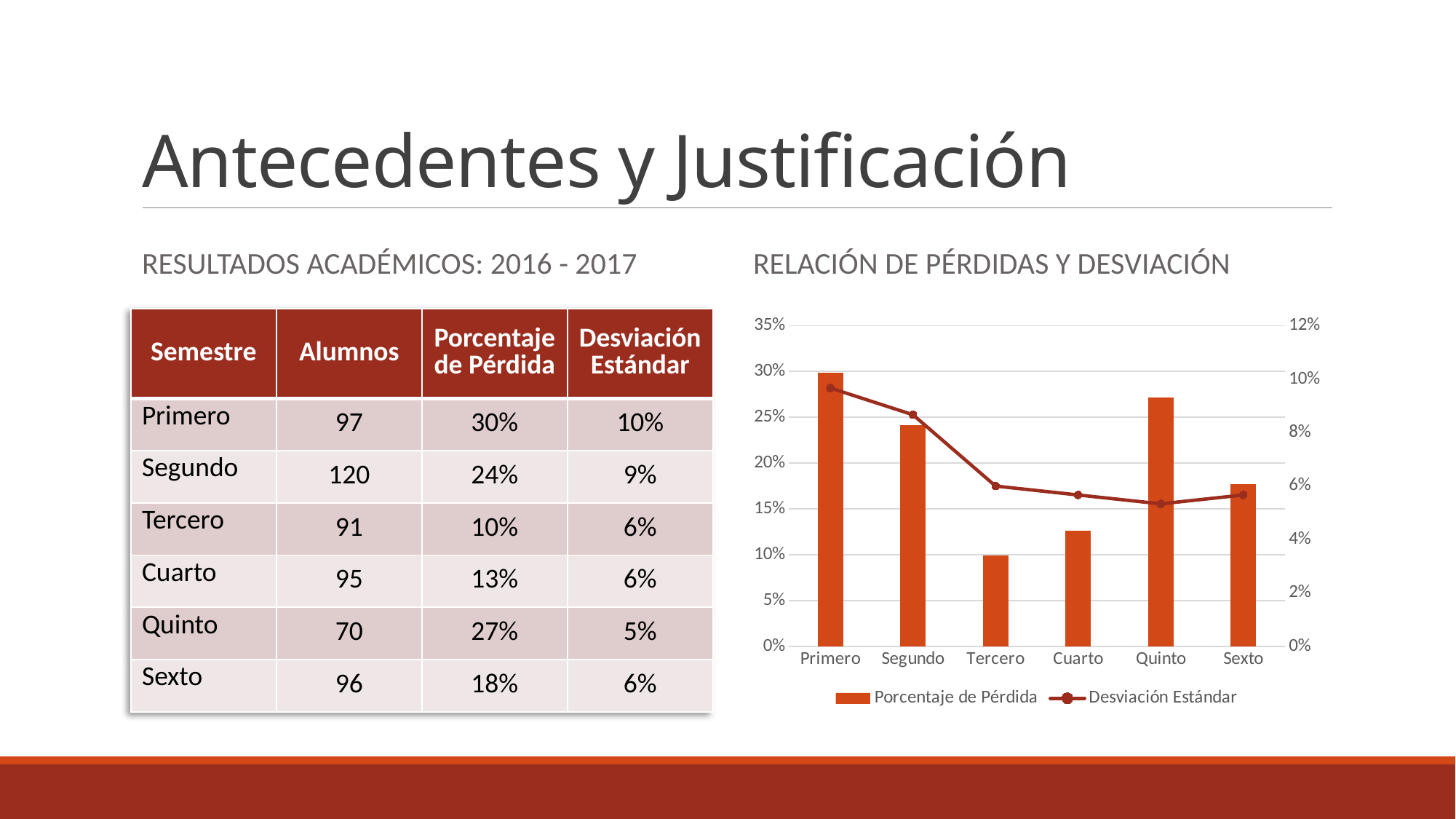
Which semester has the highest Porcentaje de Pérdida bar in the chart? Primero How many semesters are shown on the x axis of the chart? 6 Which has the taller Porcentaje de Pérdida bar, Segundo or Sexto? Segundo What are the two series named in the chart legend? Porcentaje de Pérdida and Desviación Estándar What kind of chart is shown under 'Relación de pérdidas y desviación'? A bar chart combined with a line Is the Porcentaje de Pérdida bar for Cuarto greater or less than 15%? less Does the Desviación Estándar line rise or fall from Primero to Quinto? It falls Which semester has the lowest Porcentaje de Pérdida bar in the chart? Tercero Is the Porcentaje de Pérdida bar for Quinto greater or less than 25%? greater How many series does the chart legend list? 2 On the right-hand axis, is the Desviación Estándar value for Primero greater or less than 8%? greater At which semester is the Desviación Estándar line at its highest point? Primero